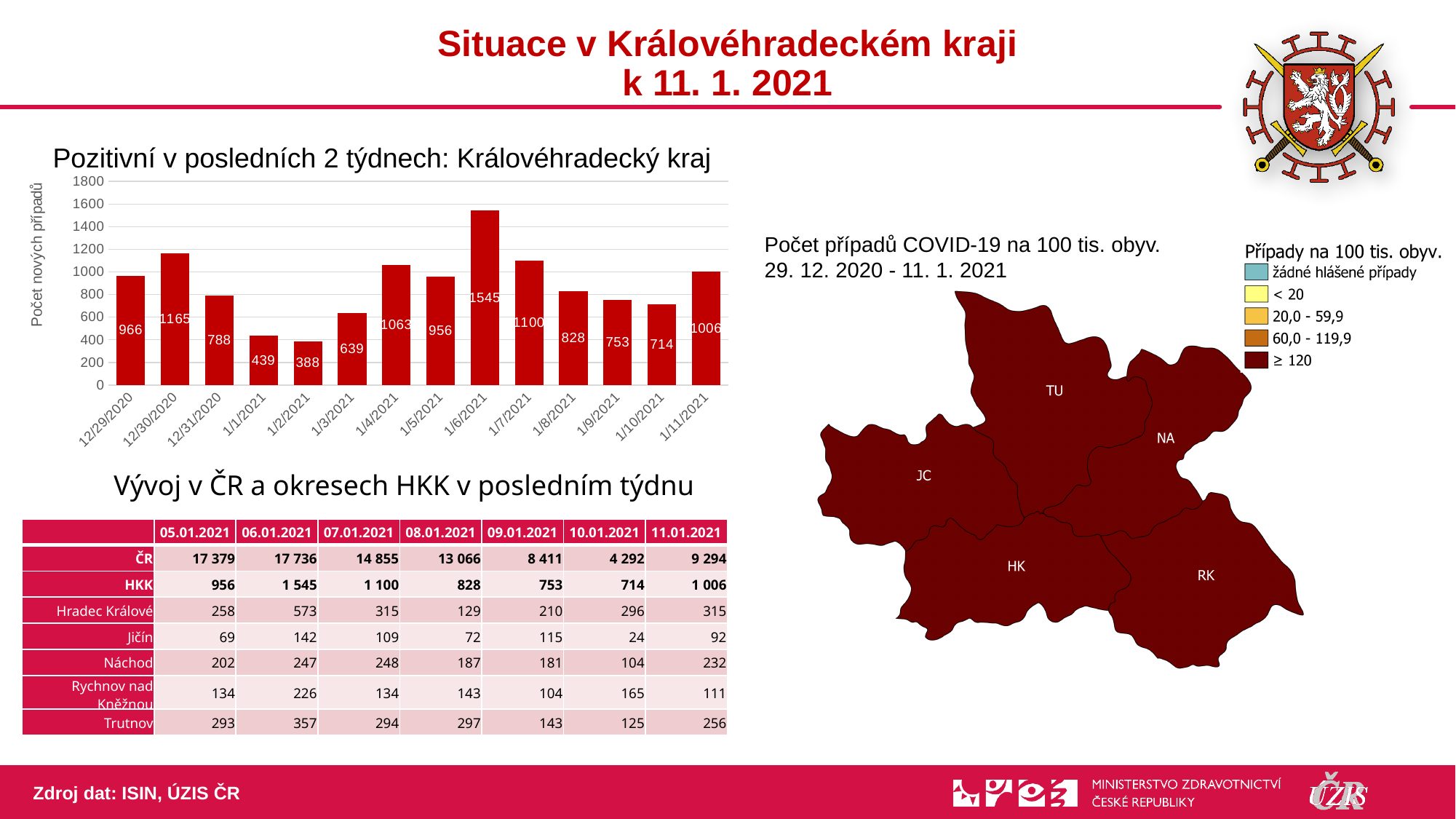
In the bar chart 'Pozitivní v posledních 2 týdnech: Královéhradecký kraj', what is the difference between the values for 1/7/2021 and 1/8/2021? 272 How many bars are shown in the bar chart 'Pozitivní v posledních 2 týdnech: Královéhradecký kraj'? 14 In the bar chart 'Pozitivní v posledních 2 týdnech: Královéhradecký kraj', what is the value for 1/6/2021? 1545 In the bar chart 'Pozitivní v posledních 2 týdnech: Královéhradecký kraj', what is the value for 12/29/2020? 966 In the bar chart 'Pozitivní v posledních 2 týdnech: Královéhradecký kraj', what is the difference between the values for 1/6/2021 and 1/2/2021? 1157 What kind of chart is 'Pozitivní v posledních 2 týdnech: Královéhradecký kraj'? bar chart In the bar chart 'Pozitivní v posledních 2 týdnech: Královéhradecký kraj', which date has the highest value? 1/6/2021 In the bar chart 'Pozitivní v posledních 2 týdnech: Královéhradecký kraj', what is the value for 1/11/2021? 1006 In the bar chart 'Pozitivní v posledních 2 týdnech: Královéhradecký kraj', which is larger, the value for 1/4/2021 or 1/5/2021? 1/4/2021 In the bar chart 'Pozitivní v posledních 2 týdnech: Královéhradecký kraj', is the value for 1/7/2021 greater or less than 1000? greater In the bar chart 'Pozitivní v posledních 2 týdnech: Královéhradecký kraj', do the values rise or fall from 1/6/2021 to 1/10/2021? fall In the bar chart 'Pozitivní v posledních 2 týdnech: Královéhradecký kraj', which date has the lowest value? 1/2/2021